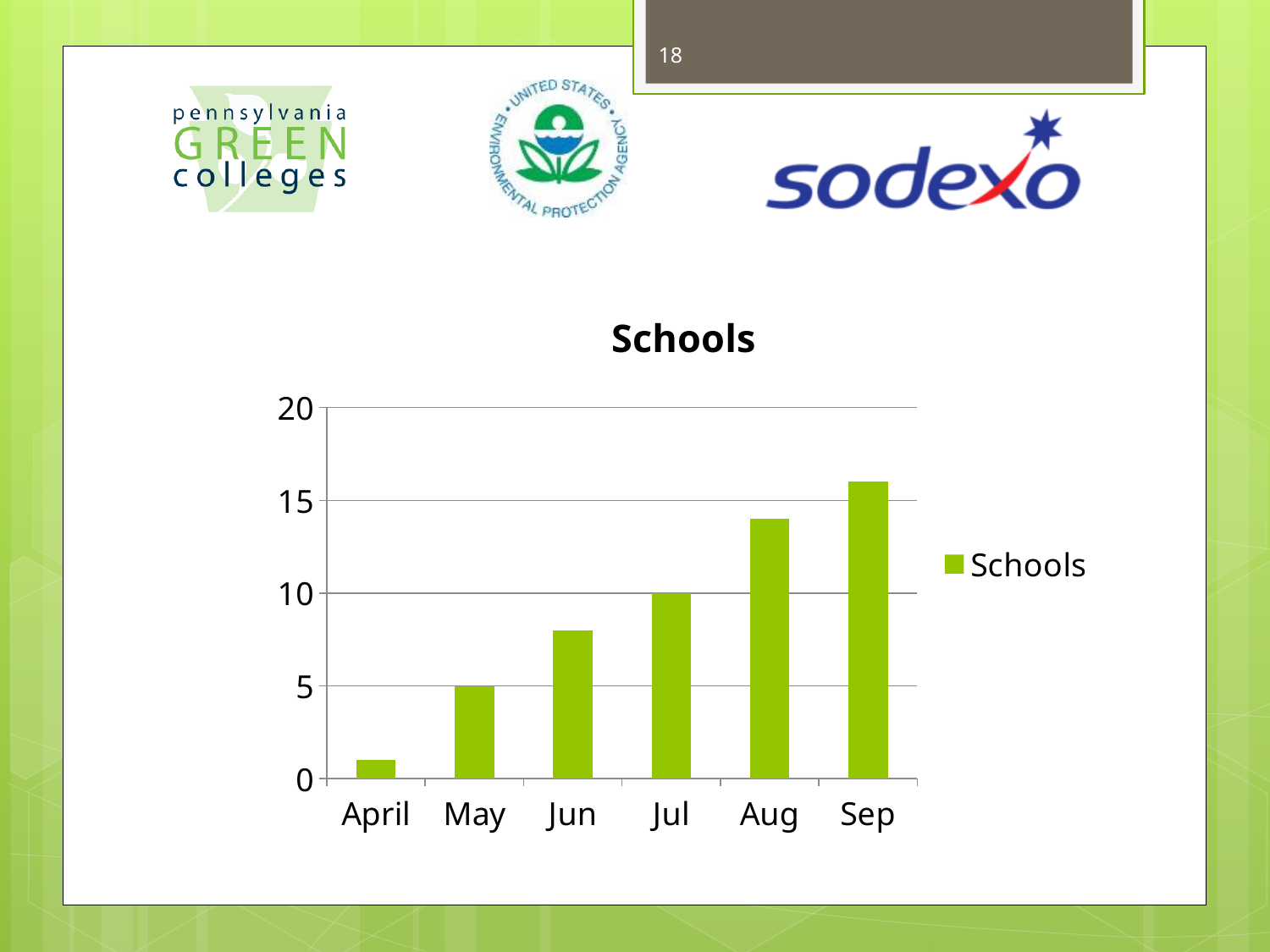
What is the title of the chart? Schools How many months are shown on the x axis of the chart? 6 What is the value for Jul? 10 What type of chart is shown on the slide? bar chart How many series does the legend list? 1 Which month has the highest value? Sep Which month has the lowest value? April What is the value for May? 5 Is the value for Jun greater or less than 10? less Do the values rise or fall from April to Sep? rise Is the value for Aug greater or less than 10? greater Is the value for Sep greater or less than 15? greater